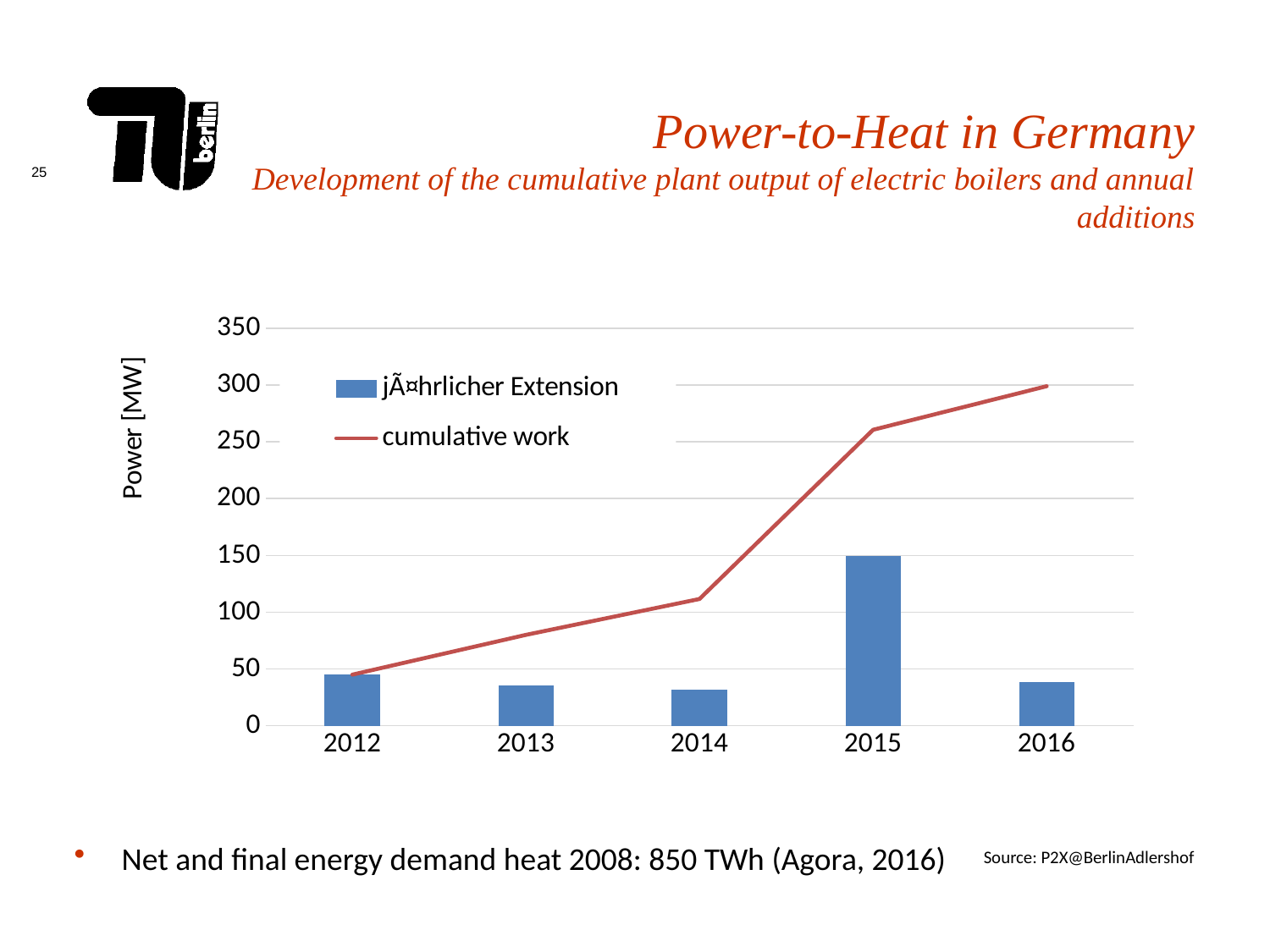
Which is larger, the annual extension bar for 2015 or for 2012? 2015 Does the cumulative work line rise or fall from 2012 to 2016? rises Is the cumulative work value for 2013 greater or less than 100? less What kind of chart is shown on the slide? A combined bar and line chart How many series does the legend list? 2 How many years are shown on the x axis? 5 Which year has the highest bar for annual extension? 2015 What is the label of the y axis? Power [MW] Is the cumulative work value for 2015 greater or less than 250? greater Is the annual extension bar for 2013 greater or less than 50? less